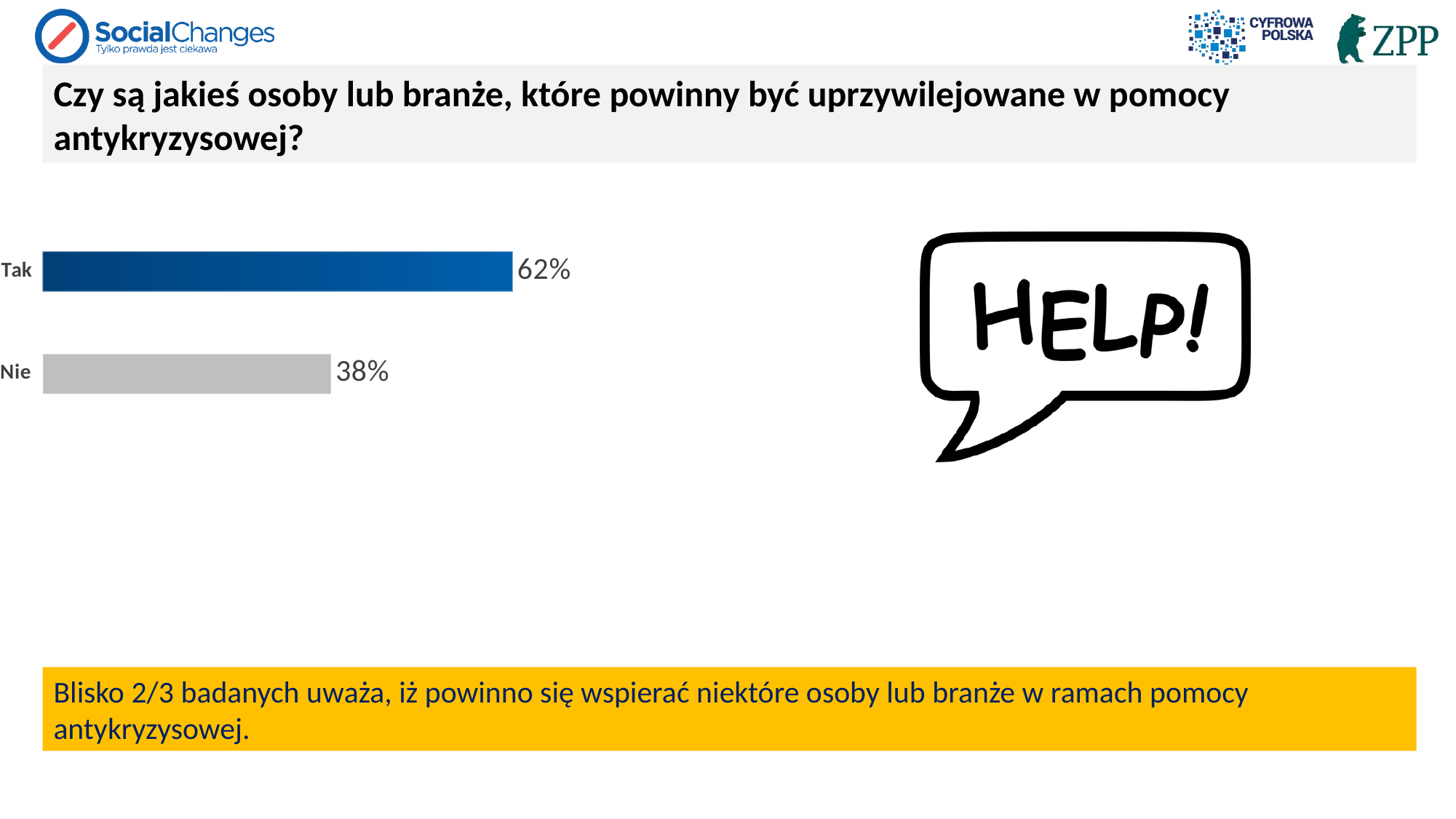
Which is larger, the value for Tak or the value for Nie? Tak Which category has the lowest value? Nie What is the difference between the values for Tak and Nie? 24% Which category has the highest value? Tak How many categories does the chart show? 2 What colour is the bar for Tak? blue What colour is the bar for Nie? grey What is the total of the values for Tak and Nie? 100% What is the value for Tak? 62% What kind of chart is shown on the slide? bar chart What is the value for Nie? 38%